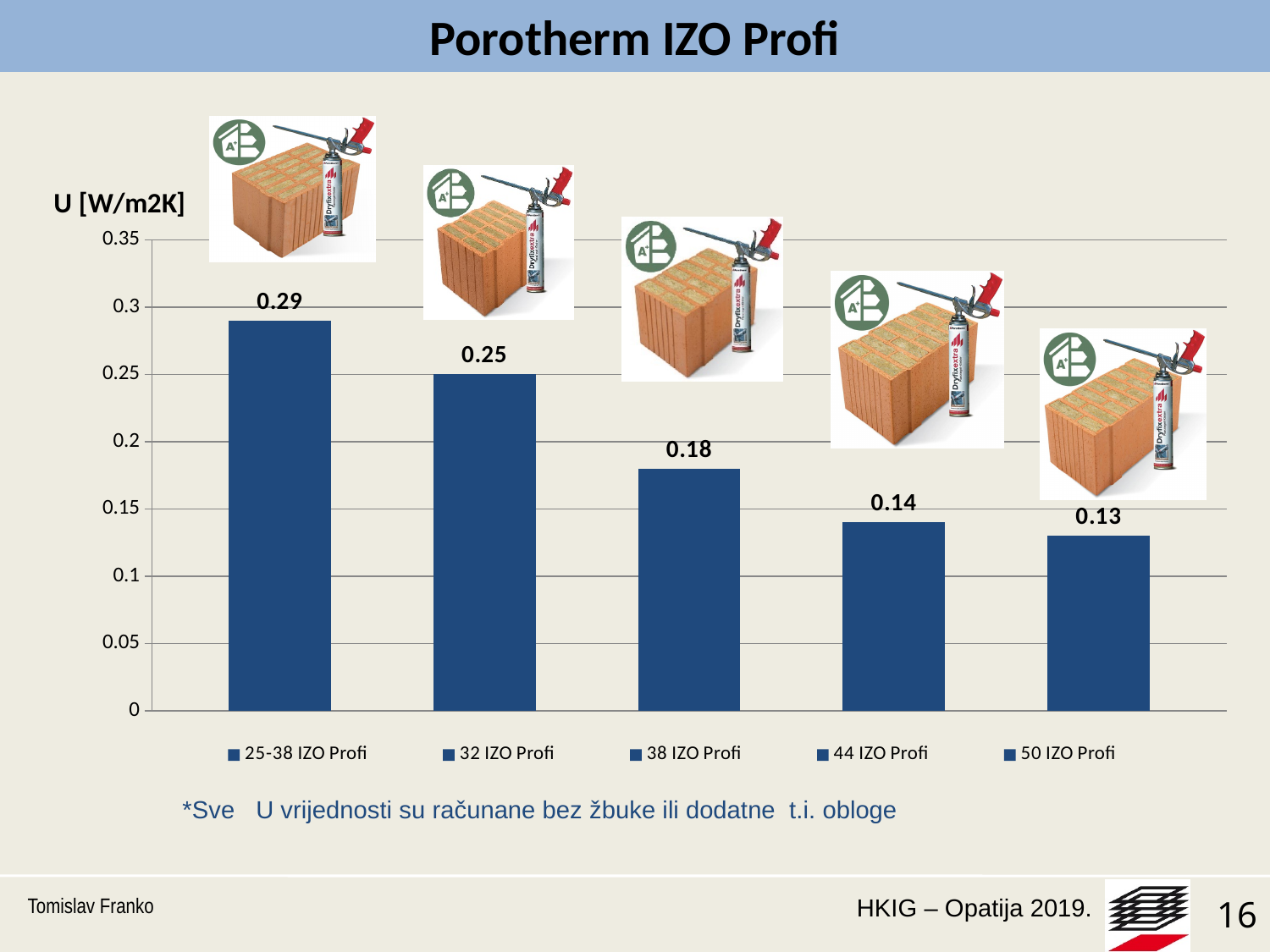
What kind of chart is shown on the slide? bar chart How many products are shown in the chart? 5 Which product has the lowest U value? 50 IZO Profi What is the U value for 38 IZO Profi? 0.18 Which has a larger U value, 32 IZO Profi or 38 IZO Profi? 32 IZO Profi Do the U values rise or fall from left to right across the chart? fall What is the U value for 50 IZO Profi? 0.13 Which product has the highest U value? 25-38 IZO Profi How many entries does the legend list? 5 Is the U value for 44 IZO Profi greater or less than 0.15? less What is the difference between the U values of 32 IZO Profi and 44 IZO Profi? 0.11 What is the U value for 25-38 IZO Profi? 0.29